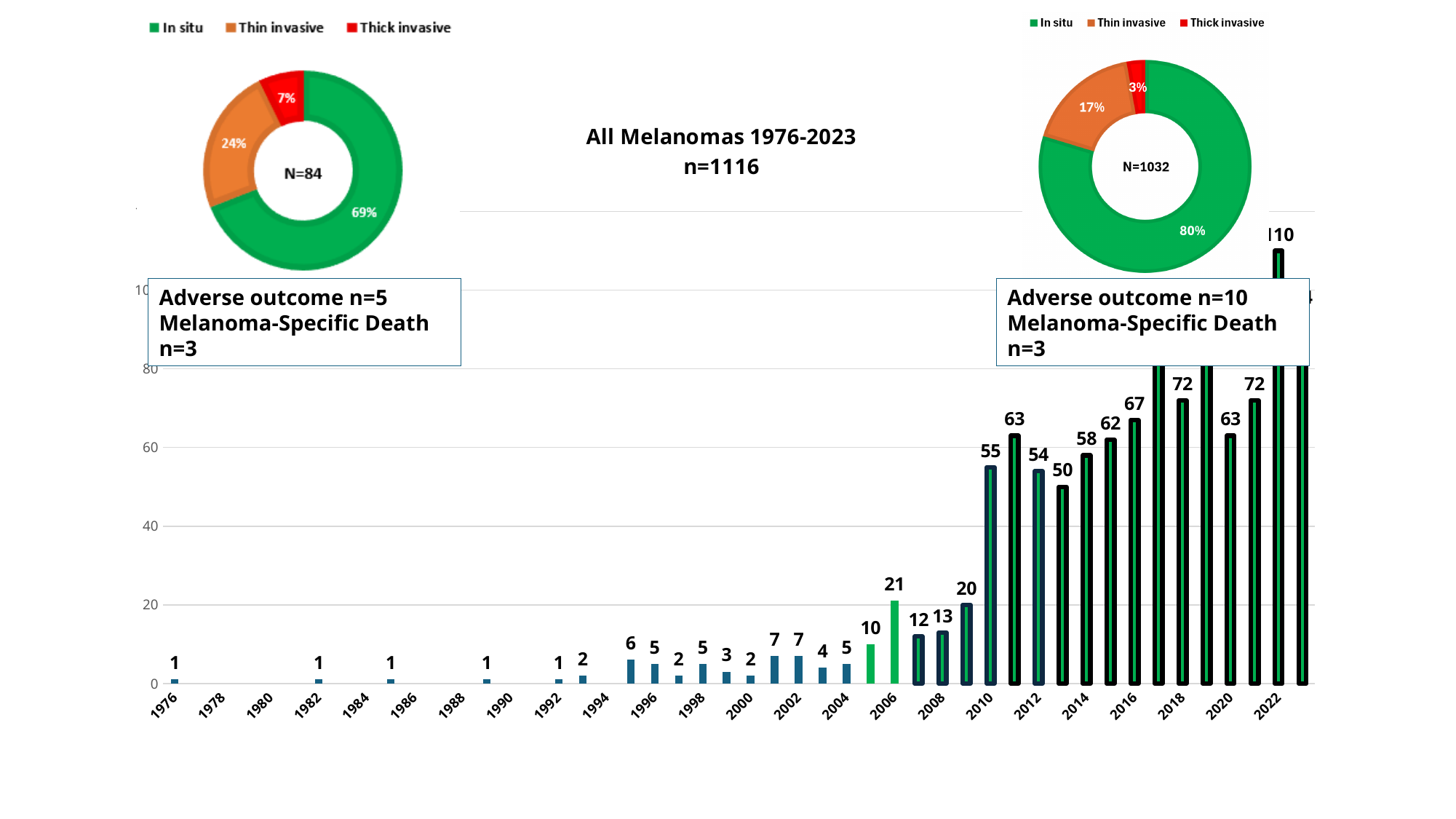
How many series does the legend of the left donut chart list? 3 In the bar chart 'All Melanomas 1976-2023', what is the value for 2010? 55 In the left donut chart (N=84), what percentage is Thick invasive? 7% What kind of chart is the chart titled 'All Melanomas 1976-2023'? bar chart In the bar chart 'All Melanomas 1976-2023', is the value for 2012 greater or less than 40? greater In the bar chart 'All Melanomas 1976-2023', which is larger, the value for 2016 or the value for 2014? 2016 In the right donut chart (N=1032), what percentage is In situ? 80% In the left donut chart (N=84), what percentage is In situ? 69% In the bar chart 'All Melanomas 1976-2023', what is the value for 2022? 110 In the bar chart 'All Melanomas 1976-2023', what is the difference between the values for 2018 and 2020? 9 In the bar chart 'All Melanomas 1976-2023', what is the value for 2006? 21